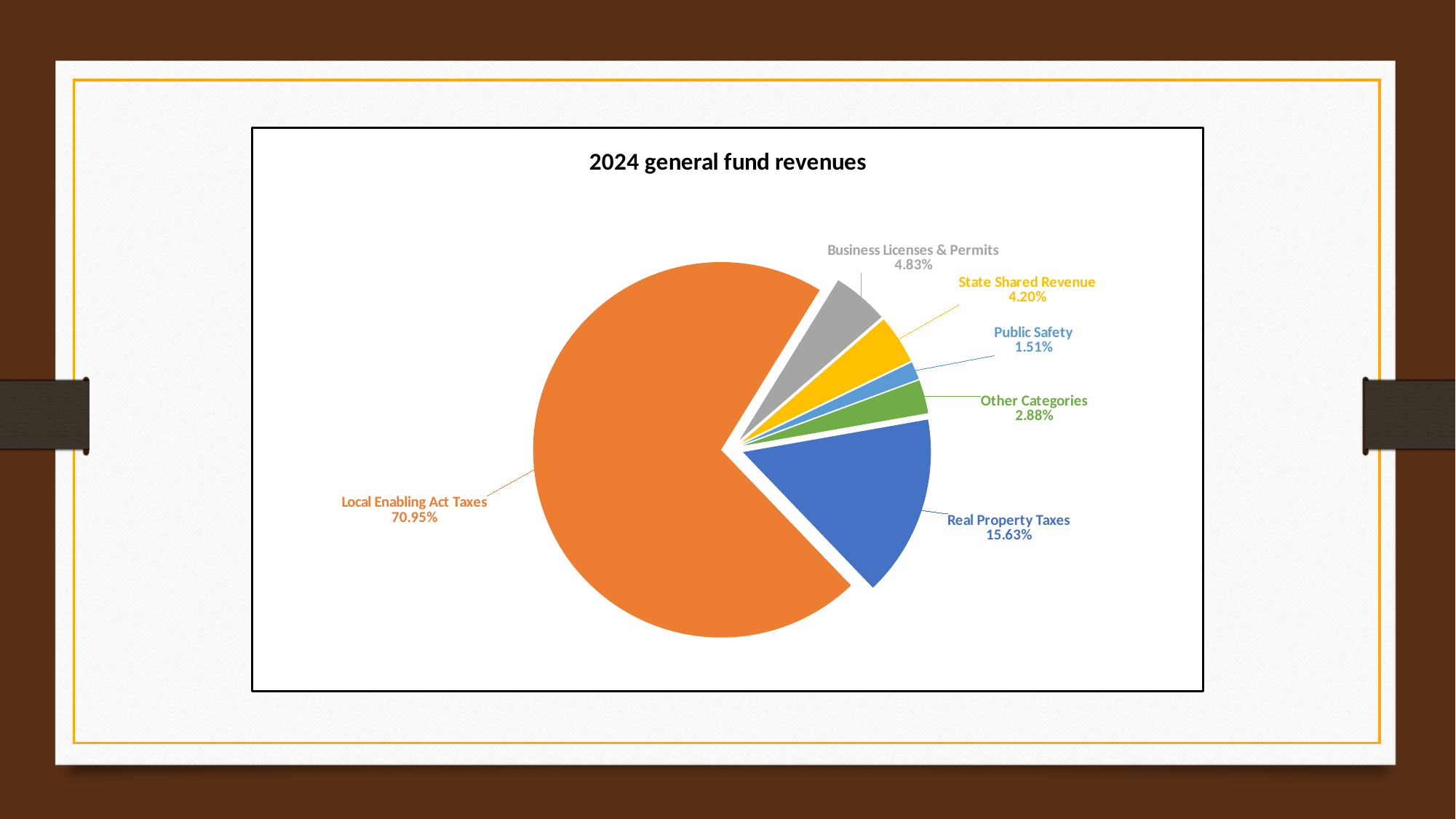
What share of 2024 general fund revenues comes from Real Property Taxes? 15.63% What is the difference in percentage points between Local Enabling Act Taxes and Real Property Taxes? 55.32 Which category has the smallest share of the pie? Public Safety What is the title of the chart? 2024 general fund revenues How many slices does the pie chart have? 6 What share of 2024 general fund revenues comes from Local Enabling Act Taxes? 70.95% What kind of chart is shown on the slide? pie chart What percentage is shown for Business Licenses & Permits? 4.83% Which category has the largest share of the pie? Local Enabling Act Taxes What percentage is shown for Public Safety? 1.51% What percentage is shown for Other Categories? 2.88% What percentage is shown for State Shared Revenue? 4.20%